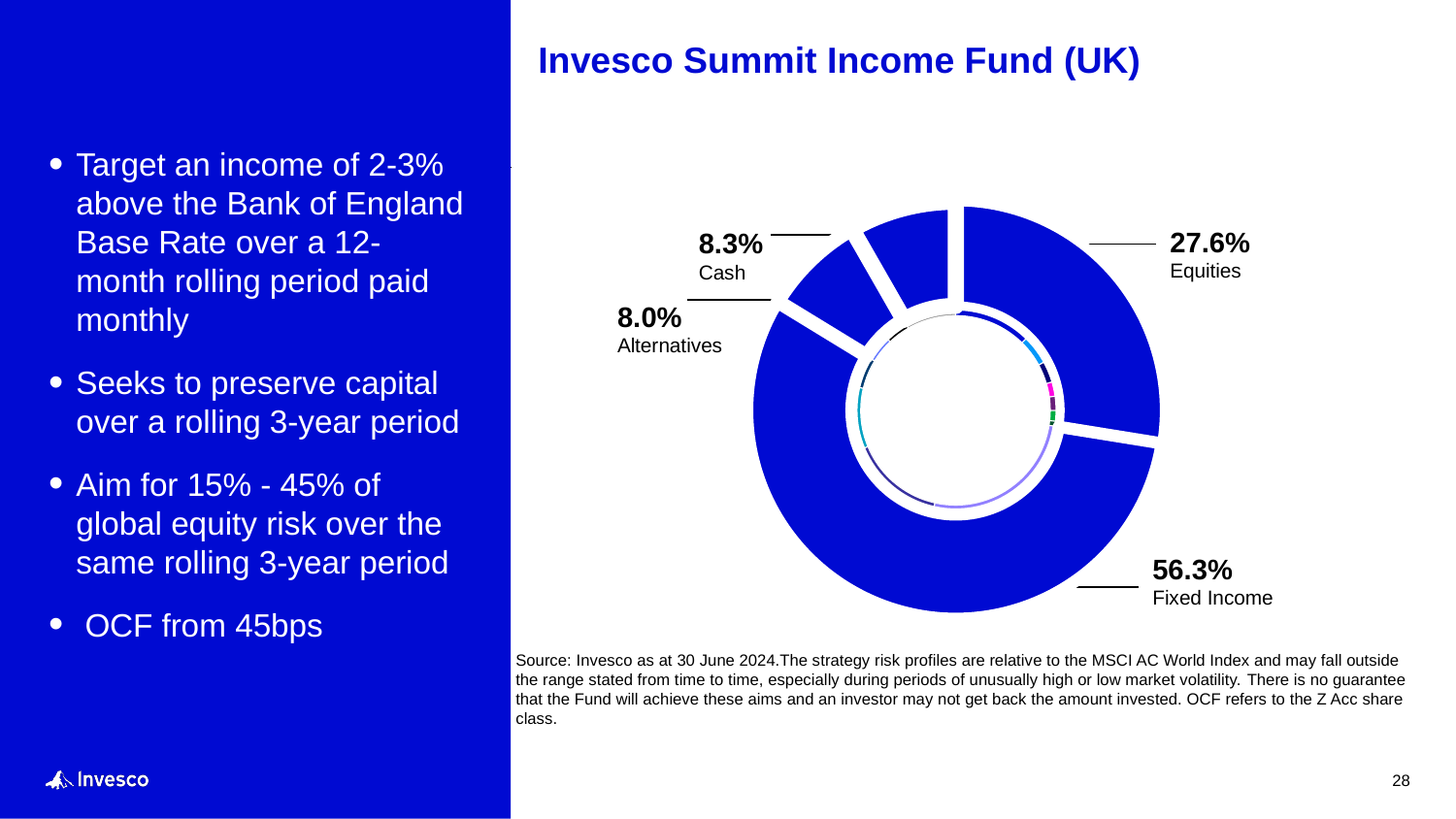
What percentage of the fund is allocated to Equities? 27.6% What percentage of the fund is allocated to Alternatives? 8.0% Which asset class has the largest share of the fund? Fixed Income What percentage of the fund is allocated to Cash? 8.3% What is the difference in percentage points between the Cash and Alternatives allocations? 0.3% What kind of chart is shown on the slide? doughnut chart What is the difference in percentage points between the Fixed Income and Equities allocations? 28.7% How many asset classes are labelled on the chart? 4 What percentage of the fund is allocated to Fixed Income? 56.3% Which is larger, the allocation to Equities or the allocation to Fixed Income? Fixed Income What is the title of the slide containing the chart? Invesco Summit Income Fund (UK) Which asset class has the smallest share of the fund? Alternatives